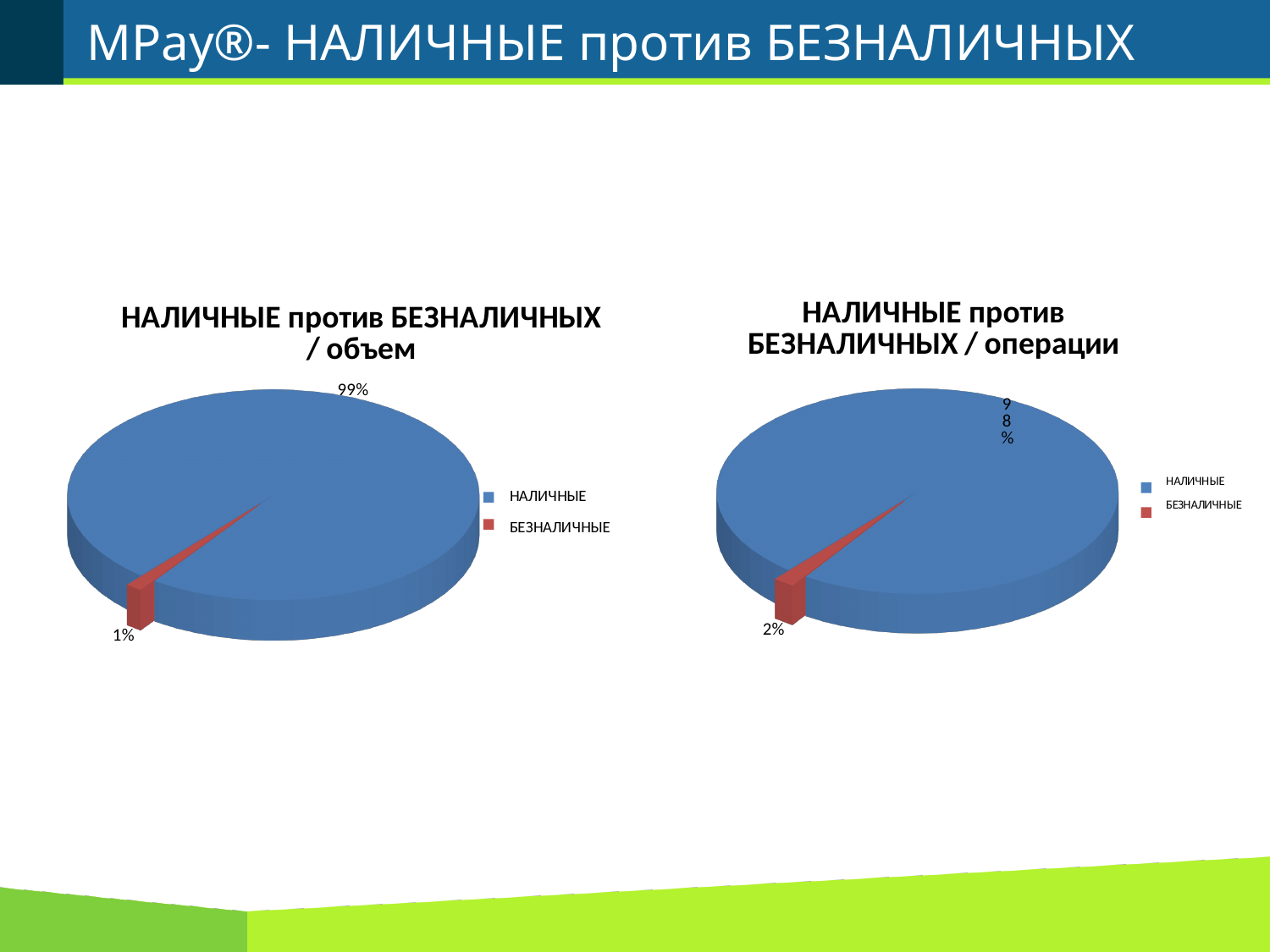
Which chart shows a larger share for БЕЗНАЛИЧНЫЕ, the left one (объем) or the right one (операции)? the right one (операции) In the left chart, what colour is the НАЛИЧНЫЕ slice? blue In the chart titled 'НАЛИЧНЫЕ против БЕЗНАЛИЧНЫХ / объем', what share of the pie is БЕЗНАЛИЧНЫЕ? 1% In the chart titled 'НАЛИЧНЫЕ против БЕЗНАЛИЧНЫХ / операции', what share of the pie is НАЛИЧНЫЕ? 98% In the left chart, what is the difference in percentage points between the НАЛИЧНЫЕ and БЕЗНАЛИЧНЫЕ slices? 98 In the right chart, what is the difference in percentage points between the НАЛИЧНЫЕ and БЕЗНАЛИЧНЫЕ slices? 96 In the chart titled 'НАЛИЧНЫЕ против БЕЗНАЛИЧНЫХ / операции', what share of the pie is БЕЗНАЛИЧНЫЕ? 2% How many categories does the legend of the right chart list? 2 What type of chart is the left chart on the slide? pie chart In the left chart, which category has the largest slice? НАЛИЧНЫЕ In the right chart, which category has the smallest slice? БЕЗНАЛИЧНЫЕ